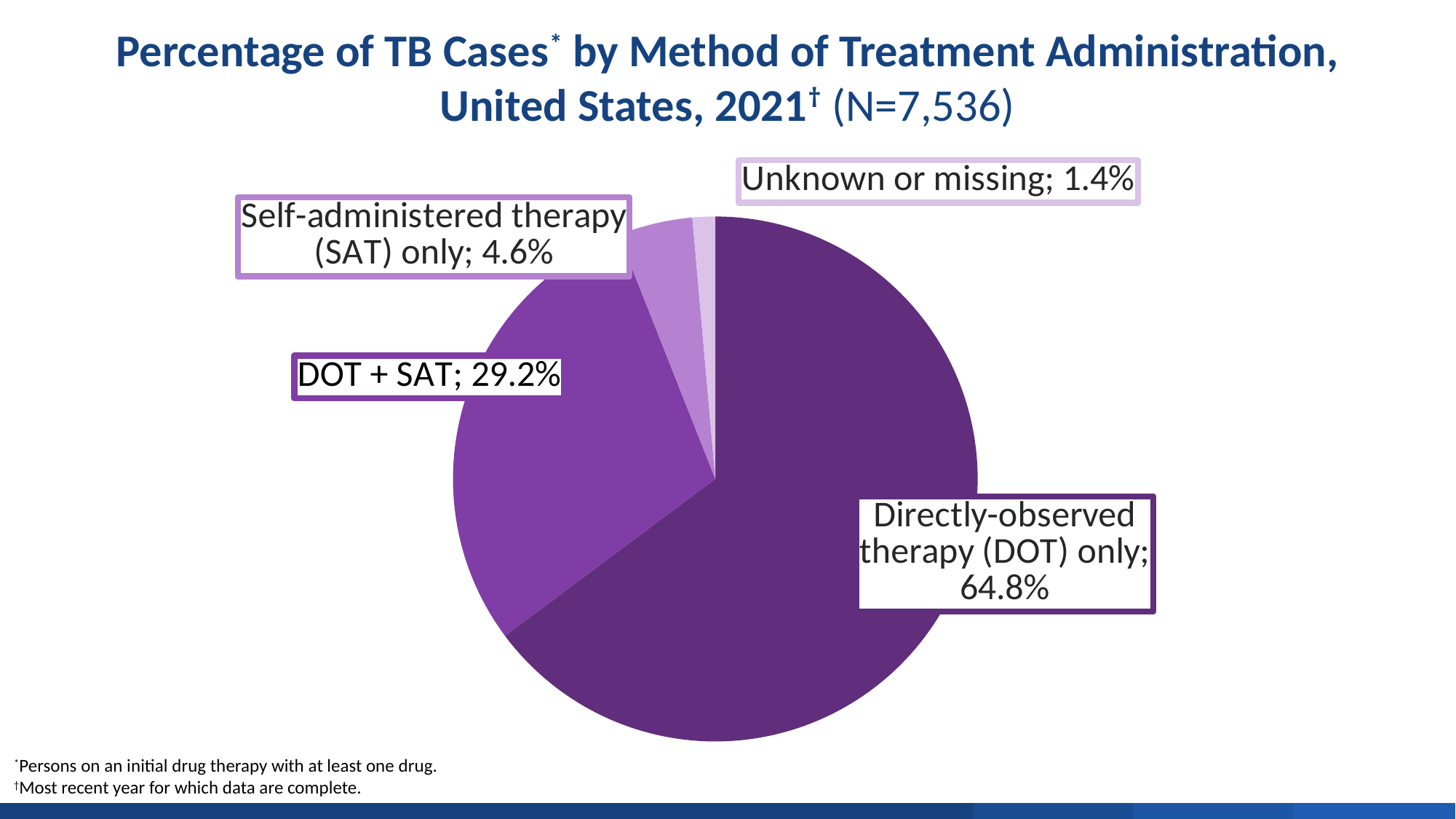
What percentage of TB cases have an unknown or missing method of treatment administration? 1.4% Which category accounts for the smallest share of TB cases? Unknown or missing What year does the chart cover? 2021 What percentage of TB cases were treated with directly-observed therapy (DOT) only? 64.8% What percentage of TB cases were treated with self-administered therapy (SAT) only? 4.6% Which is larger: the share for SAT only or the share for Unknown or missing? SAT only What percentage of TB cases were treated with DOT + SAT? 29.2% What type of chart is shown on the slide? Pie chart How many categories are shown in the pie chart? 4 What is the total number of TB cases (N) stated in the chart title? 7,536 Which method of treatment administration accounts for the largest share of TB cases? Directly-observed therapy (DOT) only What is the difference in percentage points between DOT only and DOT + SAT? 35.6